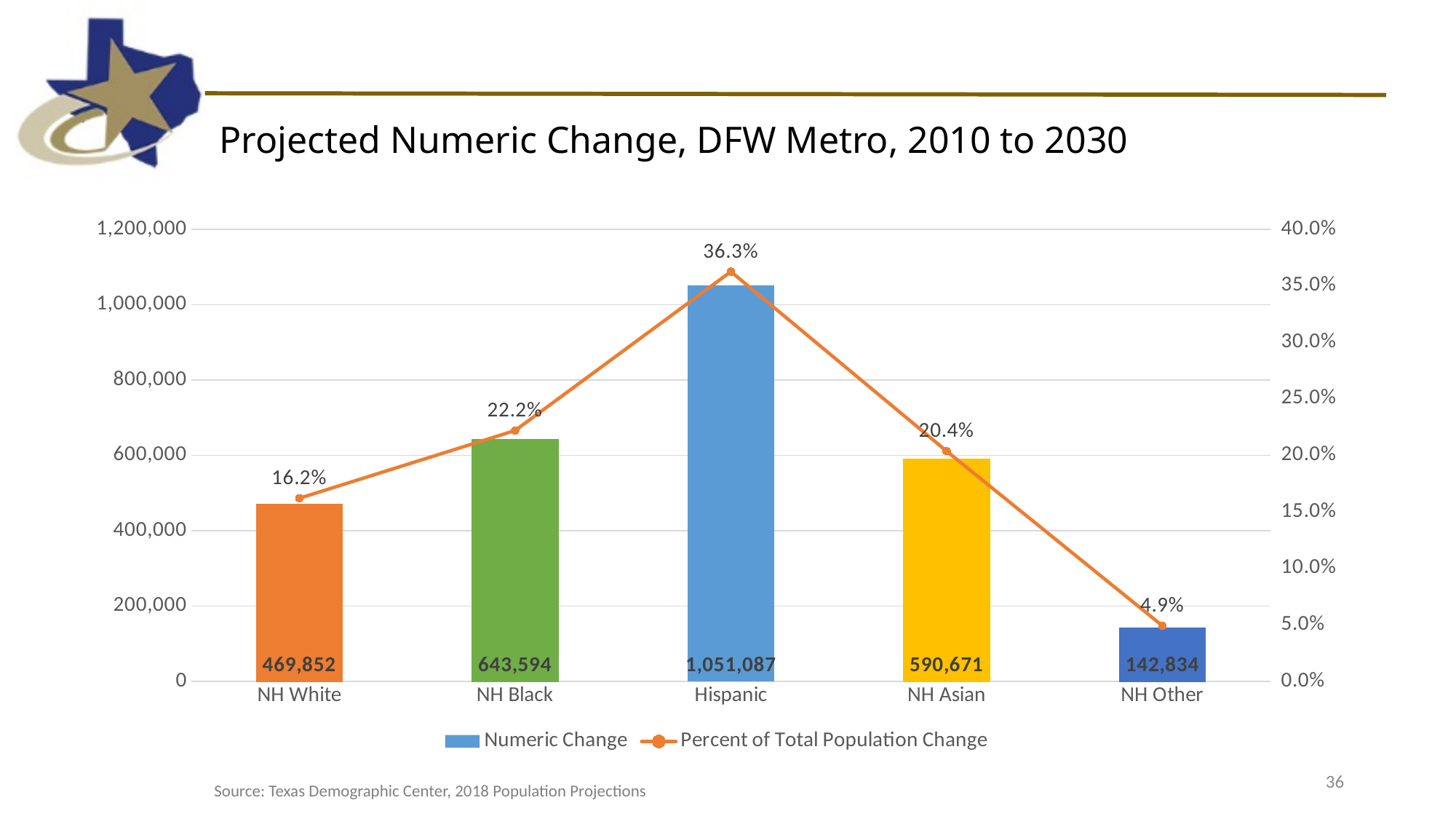
Which category has the lowest percent of total population change? NH Other What is the projected numeric change for NH Other? 142,834 What is the title of the chart? Projected Numeric Change, DFW Metro, 2010 to 2030 What is the projected numeric change for Hispanic in the DFW Metro from 2010 to 2030? 1,051,087 Which category has the highest projected numeric change? Hispanic How many categories are shown on the x axis? 5 Which has a larger projected numeric change, NH White or NH Asian? NH Asian What percent of total population change is attributed to NH Black? 22.2% What is the percent of total population change for NH White? 16.2% What is the difference in numeric change between NH Black and NH Asian? 52,923 How many series does the legend list? 2 What kind of chart is used to show the Numeric Change series? Bar chart